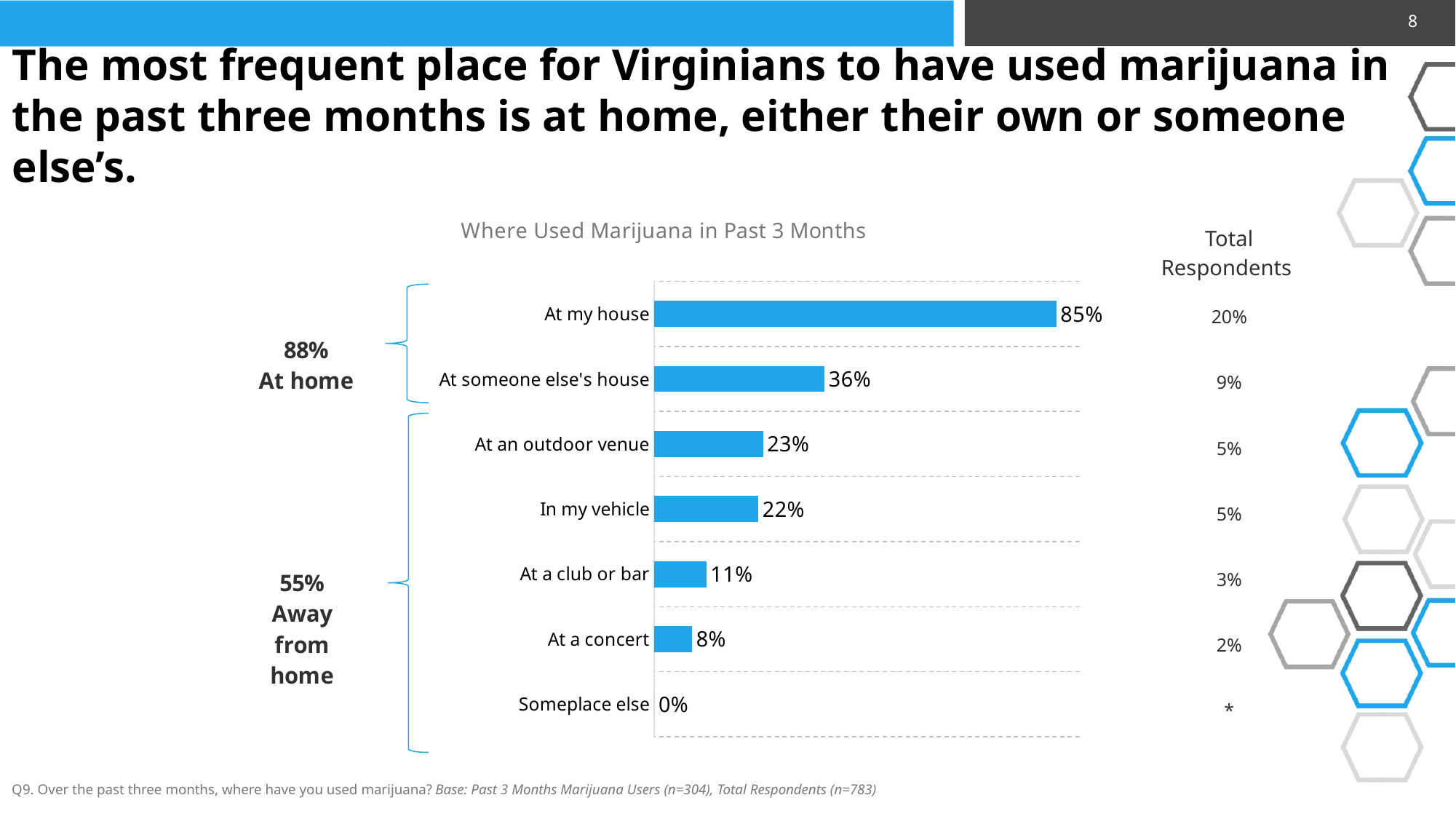
What is the title of the chart? Where Used Marijuana in Past 3 Months How many categories are plotted in the chart? 7 What is the difference between the values for 'At a club or bar' and 'At a concert'? 3% What is the value shown for 'At someone else's house'? 36% What percentage of past-3-month marijuana users said they used marijuana at my house? 85% Which is larger, the value for 'At an outdoor venue' or 'At a club or bar'? At an outdoor venue What combined percentage is shown for the 'At home' group bracket? 88% What is the difference between the values for 'At my house' and 'At someone else's house'? 49% Which category has the lowest value in the chart? Someplace else What percentage is shown for 'In my vehicle'? 22% Which category has the highest value in the chart? At my house What kind of chart is shown on the slide? Bar chart